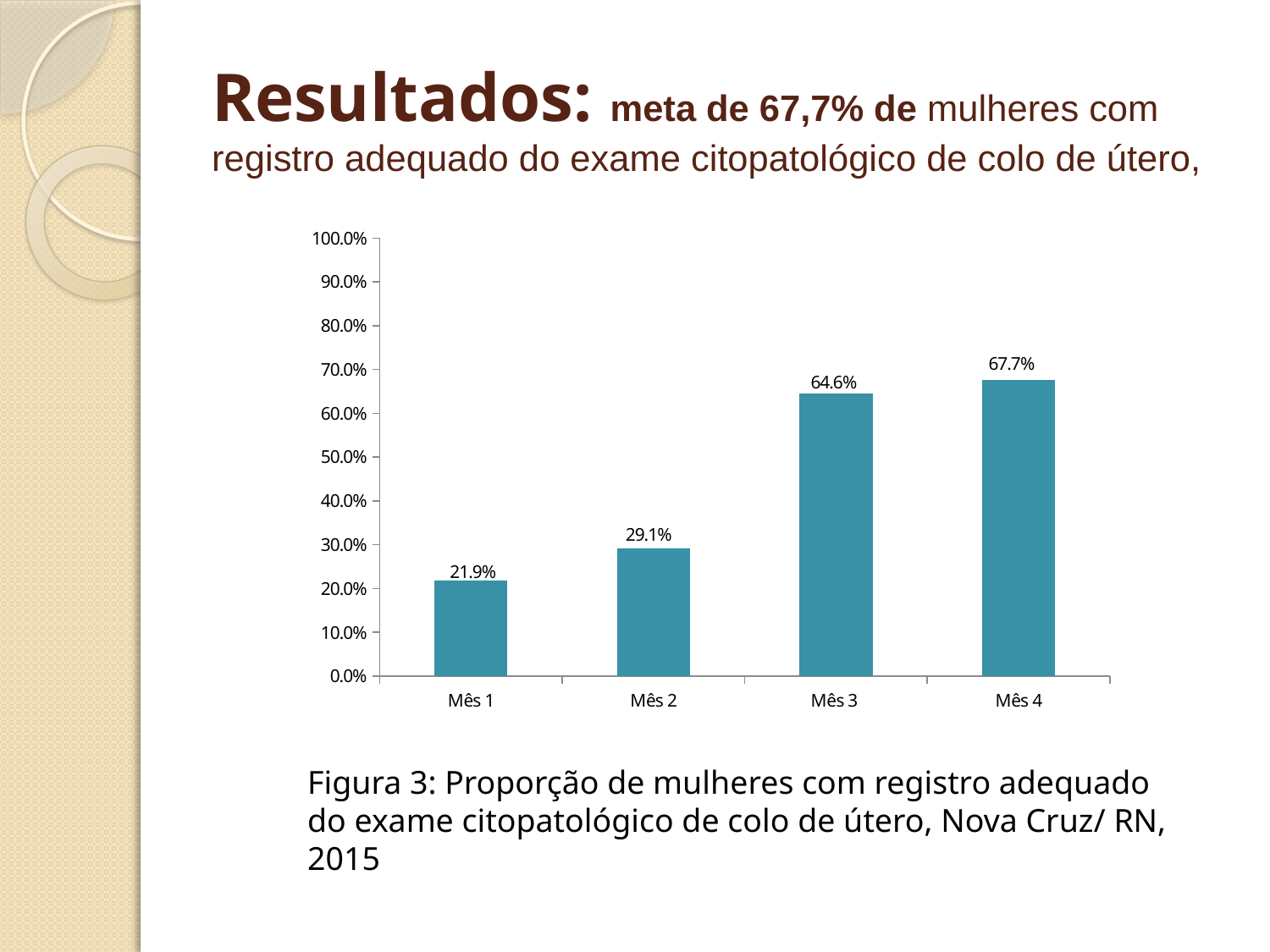
What is the value for Mês 4? 67.7% What kind of chart is shown on the slide? bar chart What is the value for Mês 3? 64.6% What is the difference between the values for Mês 3 and Mês 2? 35.5% How many months are shown on the x axis? 4 Is the value for Mês 2 greater or less than 30.0%? less Which month has the lowest value? Mês 1 What is the value for Mês 1? 21.9% Do the values rise or fall from Mês 1 to Mês 4? rise Which month has the highest value? Mês 4 What is the difference between the values for Mês 2 and Mês 1? 7.2% Which is larger, the value for Mês 2 or the value for Mês 3? Mês 3